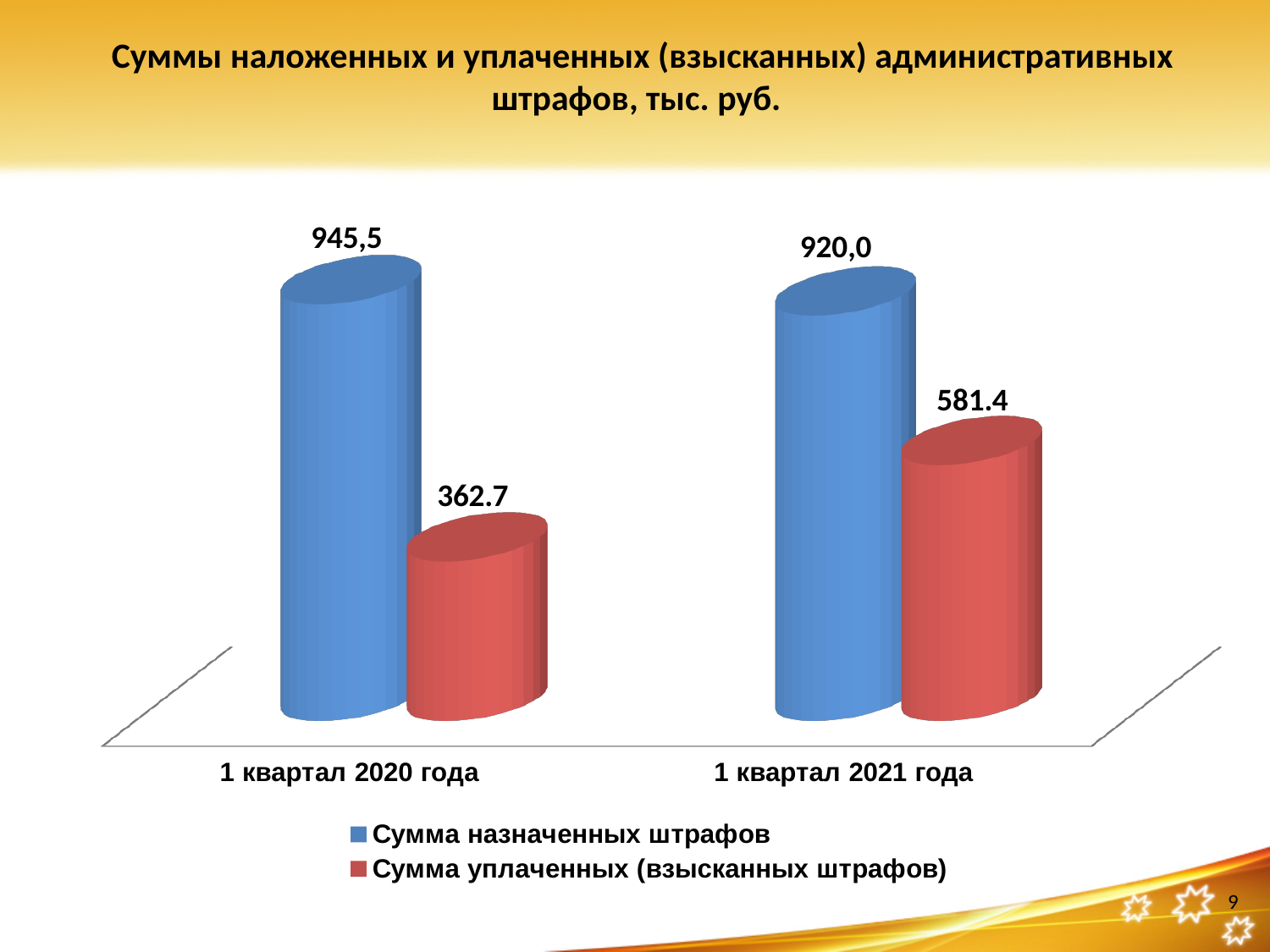
What is the difference between «Сумма уплаченных (взысканных штрафов)» in «1 квартал 2021 года» and in «1 квартал 2020 года»? 218.7 What is the value of «Сумма уплаченных (взысканных штрафов)» for «1 квартал 2020 года»? 362.7 How many series does the legend list? 2 What is the value of «Сумма назначенных штрафов» for «1 квартал 2020 года»? 945,5 What is the value of «Сумма назначенных штрафов» for «1 квартал 2021 года»? 920,0 How many categories are shown on the x axis? 2 Which category has the highest value for «Сумма назначенных штрафов»? 1 квартал 2020 года Which category has the lowest value for «Сумма уплаченных (взысканных штрафов)»? 1 квартал 2020 года What is the difference between «Сумма назначенных штрафов» in «1 квартал 2020 года» and in «1 квартал 2021 года»? 25,5 Which is larger: «Сумма уплаченных (взысканных штрафов)» in «1 квартал 2020 года» or in «1 квартал 2021 года»? 1 квартал 2021 года What kind of chart is shown on the slide? Bar chart What is the value of «Сумма уплаченных (взысканных штрафов)» for «1 квартал 2021 года»? 581.4